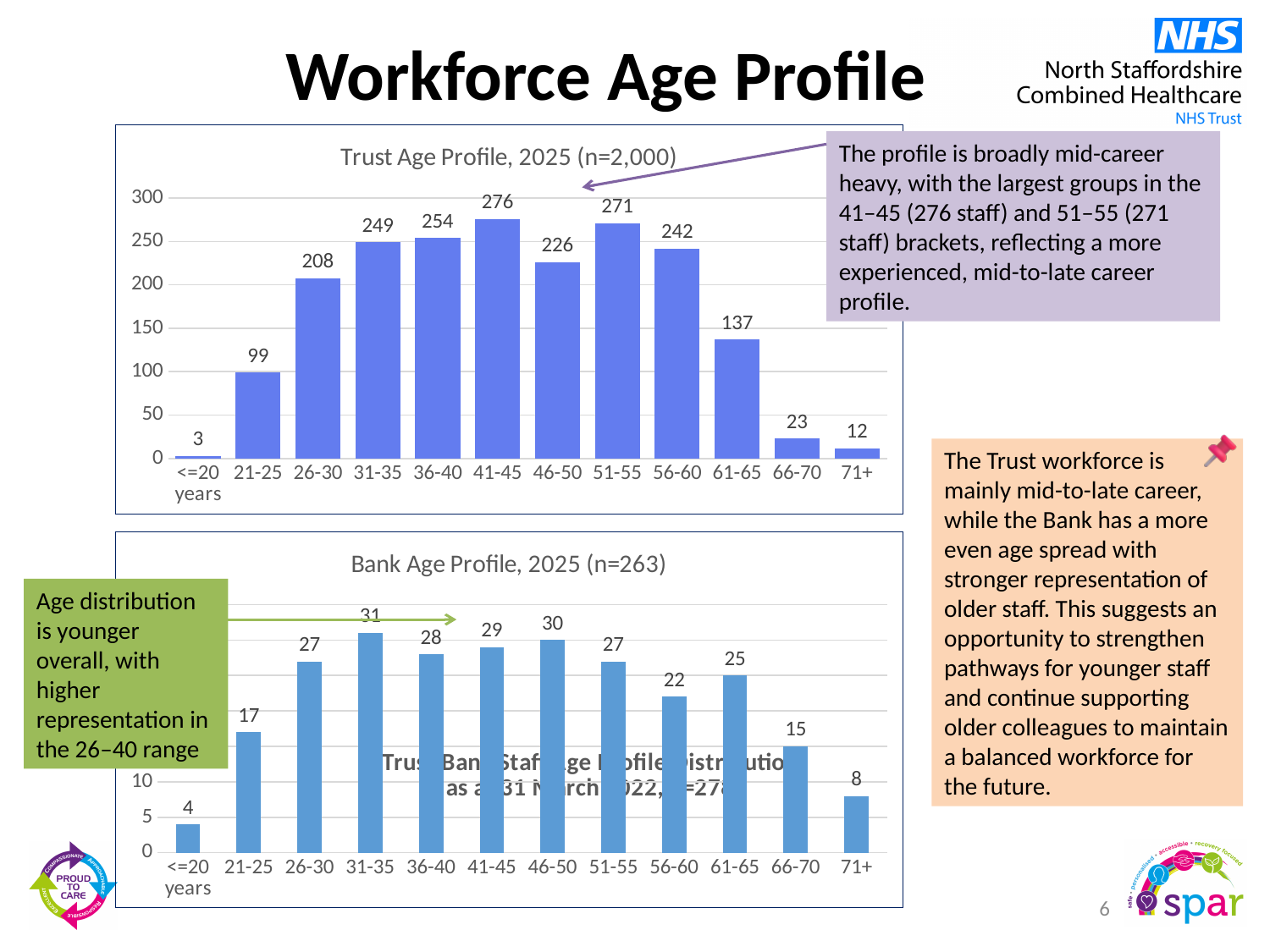
In the Bank Age Profile chart, which age band has the highest value? 31-35 In the Trust Age Profile chart, which age band has the lowest number of staff? <=20 years In the Trust Age Profile chart, what is the difference between the 56-60 and 61-65 age bands? 105 In the Bank Age Profile chart, what is the difference between the 46-50 and 56-60 age bands? 8 In the Bank Age Profile chart, what is the value for the 71+ age band? 8 What is the title of the top chart on the slide? Trust Age Profile, 2025 (n=2,000) In the Trust Age Profile chart, which is larger: the value for 31-35 or the value for 36-40? 36-40 In the Trust Age Profile chart, how many age bands are shown on the x axis? 12 In the Bank Age Profile chart, how many staff are in the 31-35 age band? 31 What type of chart is the Bank Age Profile chart? Bar chart In the Trust Age Profile chart, how many staff are in the 41-45 age band? 276 In the Trust Age Profile chart, which age band has the highest number of staff? 41-45